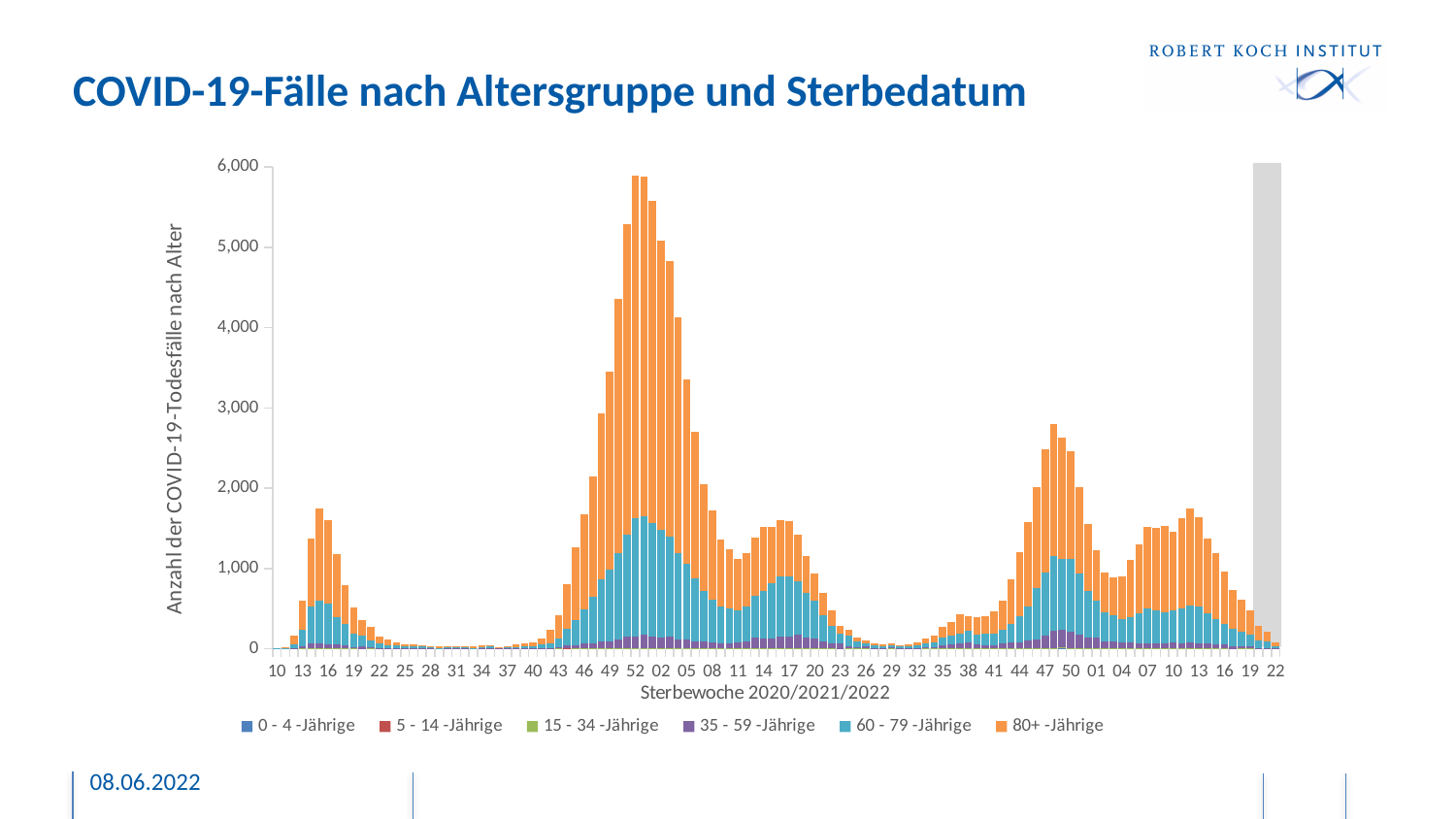
Which age group makes up the largest part of the tallest bars? 80+ -Jährige What kind of chart is shown on the slide? Stacked bar chart Is the value of the tallest bar in the late-2021 wave (around week 47/48) greater or less than 2,000? greater How many age-group series does the legend list? 6 Is the value of the tallest bar in the first wave (around week 16 of 2020) greater or less than 2,000? less Which age group does the orange series in the legend represent? 80+ -Jährige Which is taller: the peak bar around week 52 of 2020 or the peak bar around week 47 of 2021? The peak around week 52 of 2020 Is the value for week 29 of 2021 greater or less than 1,000? less What is the title of the chart on the slide? COVID-19-Fälle nach Altersgruppe und Sterbedatum Do the bar values rise or fall from week 52 of 2020 to week 26 of 2021? fall